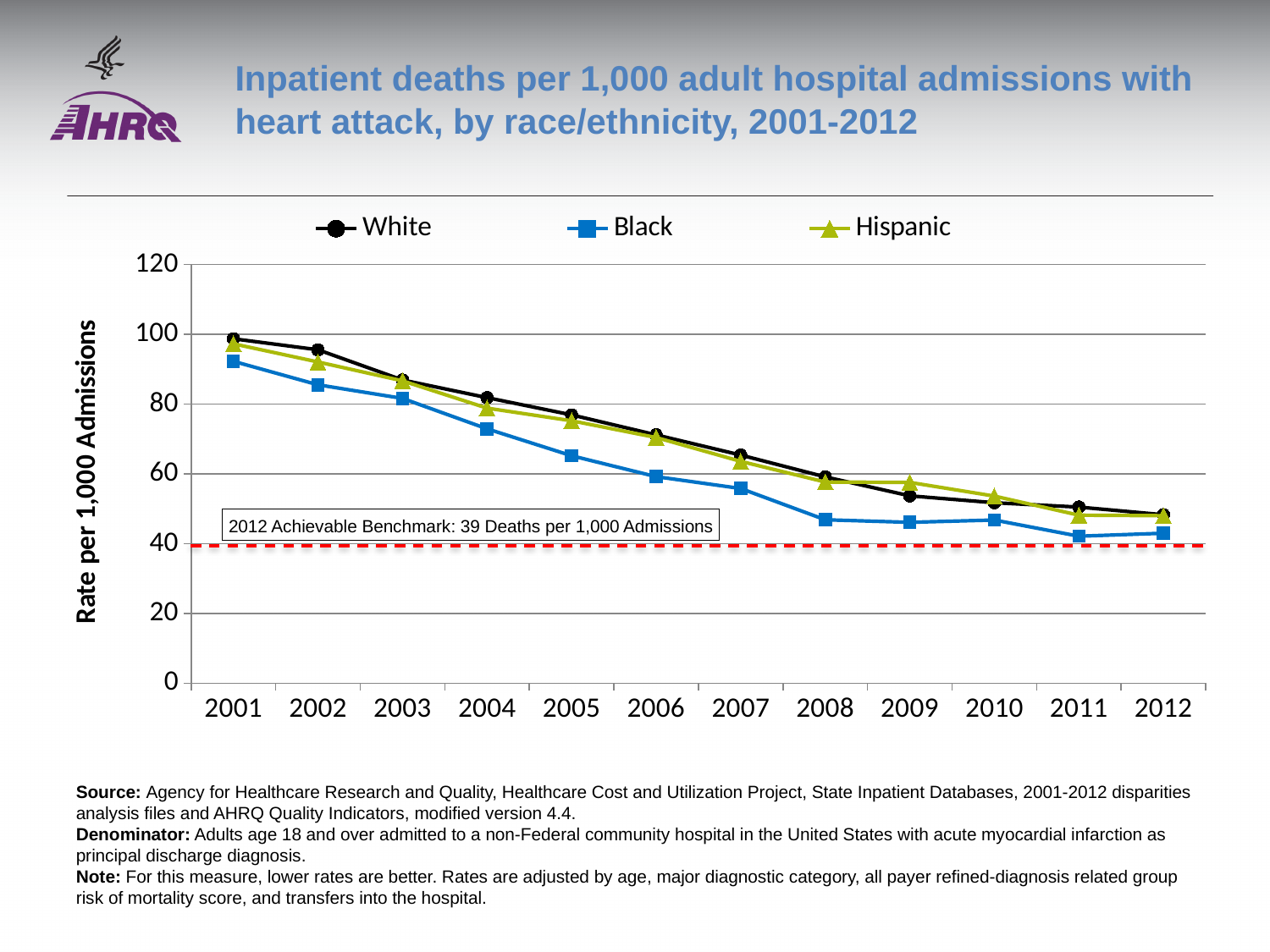
Is the value for Black in 2012 greater or less than 60? less In 2001, which series has the higher value, White or Black? White What is the 2012 achievable benchmark shown on the chart? 39 Deaths per 1,000 Admissions Is the value for White in 2001 greater or less than 80? greater What kind of chart is shown on the slide? Line chart In 2008, which series has the higher value, Black or Hispanic? Hispanic In which year is the Black series at its highest? 2001 Is the value for Black in 2008 greater or less than 60? less How many years are plotted along the x axis? 12 Do the rates for the White series rise or fall from 2001 to 2012? Fall How many series does the legend list? 3